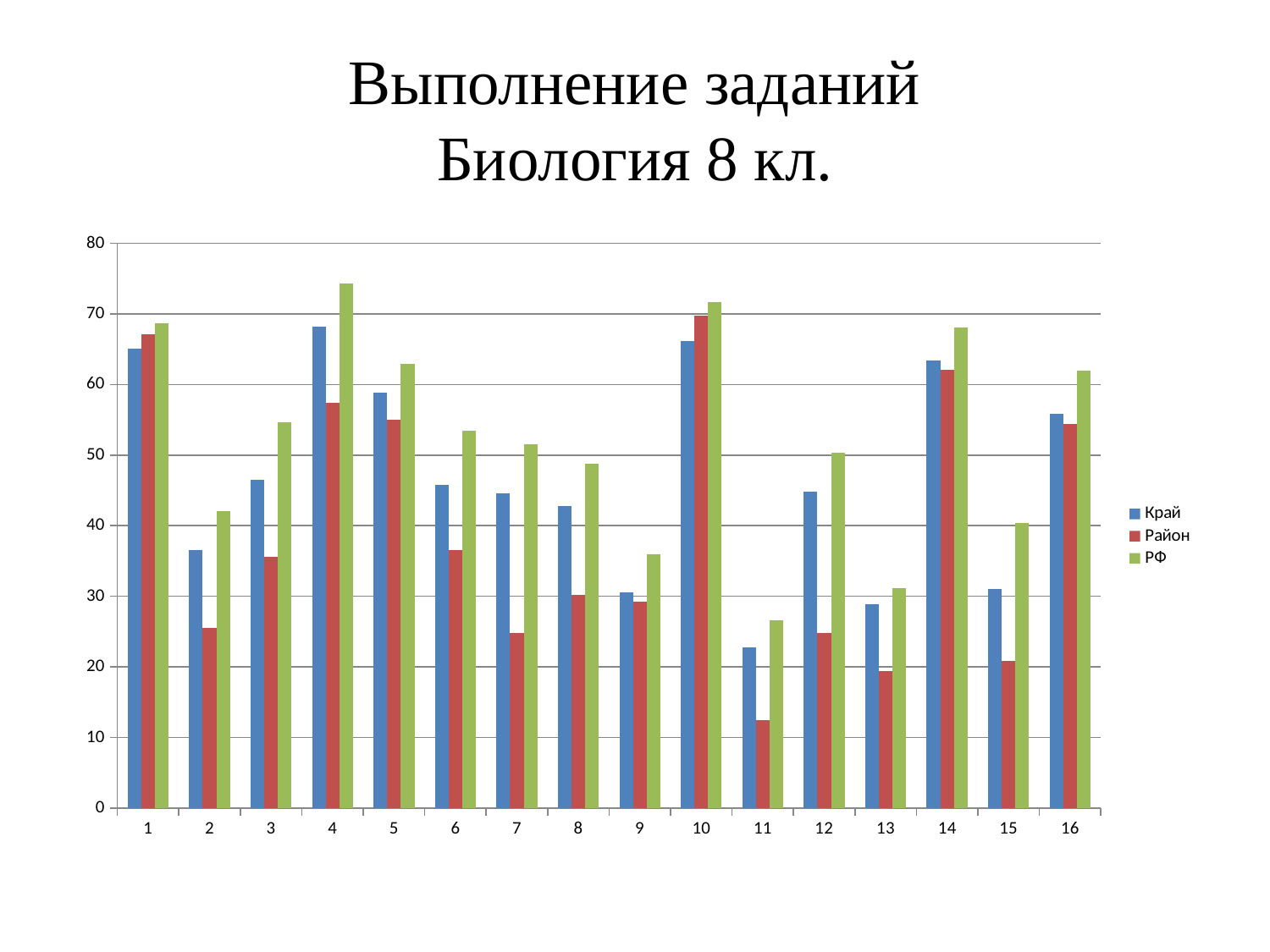
For which task is the Район value the lowest? 11 For which task is the Край value the lowest? 11 Which series are listed in the legend? Край, Район, РФ Is the РФ value for task 4 greater or less than 70? greater For which task is the РФ value the highest? 4 What kind of chart is shown on the slide? bar chart How many task categories are shown on the x axis? 16 Is the Район value for task 11 greater or less than 20? less How many series does the legend list? 3 For task 11, which is larger: the Край value or the Район value? Край Is the Район value for task 7 greater or less than 30? less